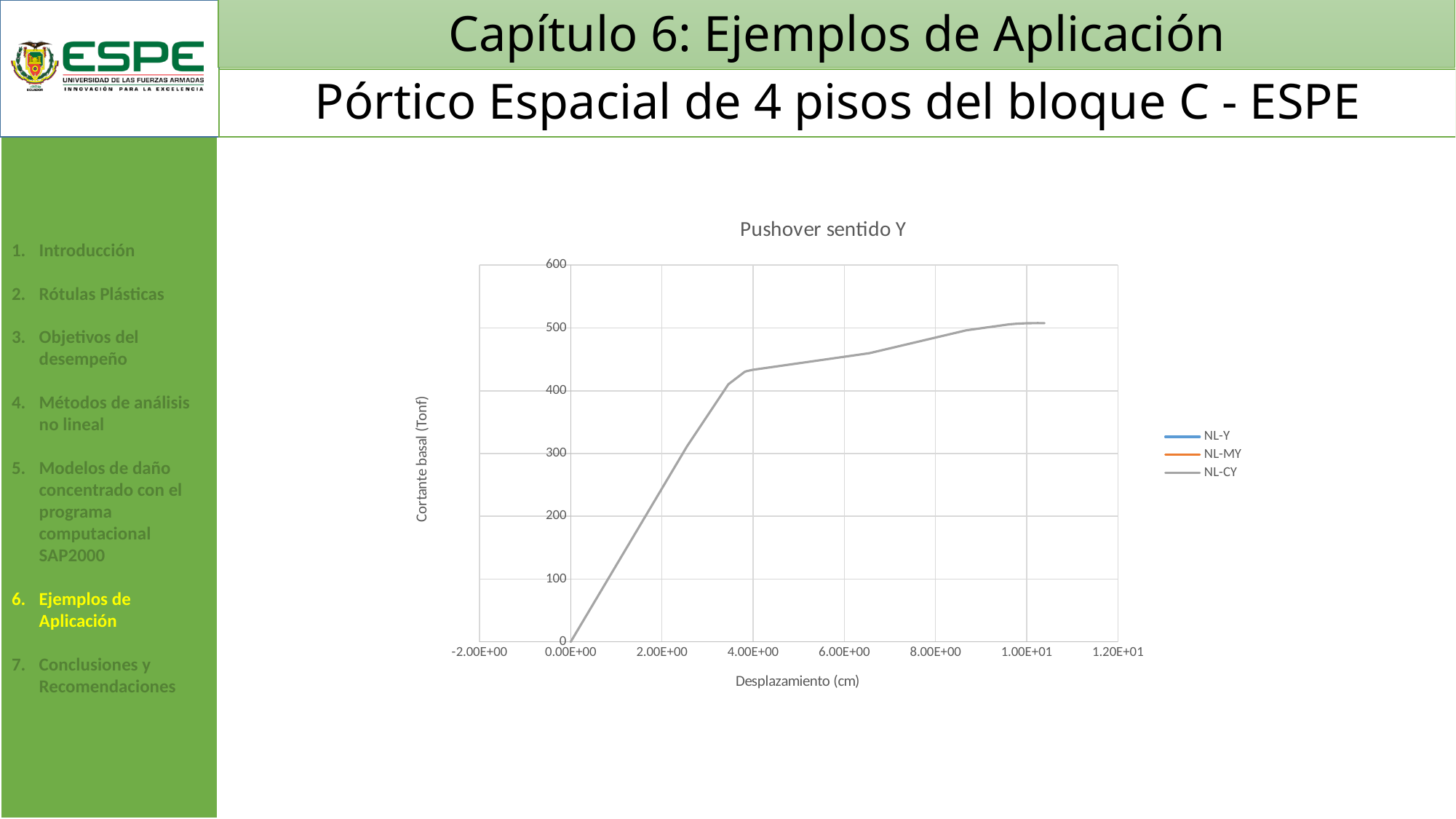
What kind of chart is shown on the slide? Line chart Is the base shear value at a displacement of 4.00E+00 cm greater or less than 400? greater Is the base shear value at a displacement of 2.00E+00 cm greater or less than 300? less Does the plotted curve rise or fall as displacement increases along the x axis? Rise What is the title of the chart? Pushover sentido Y Is the base shear value at a displacement of 8.00E+00 cm greater or less than 400? greater What is the label of the vertical axis of the chart? Cortante basal (Tonf) How many series does the chart's legend list? 3 Is the base shear at a displacement of 6.00E+00 cm larger or smaller than the base shear at 2.00E+00 cm? Larger